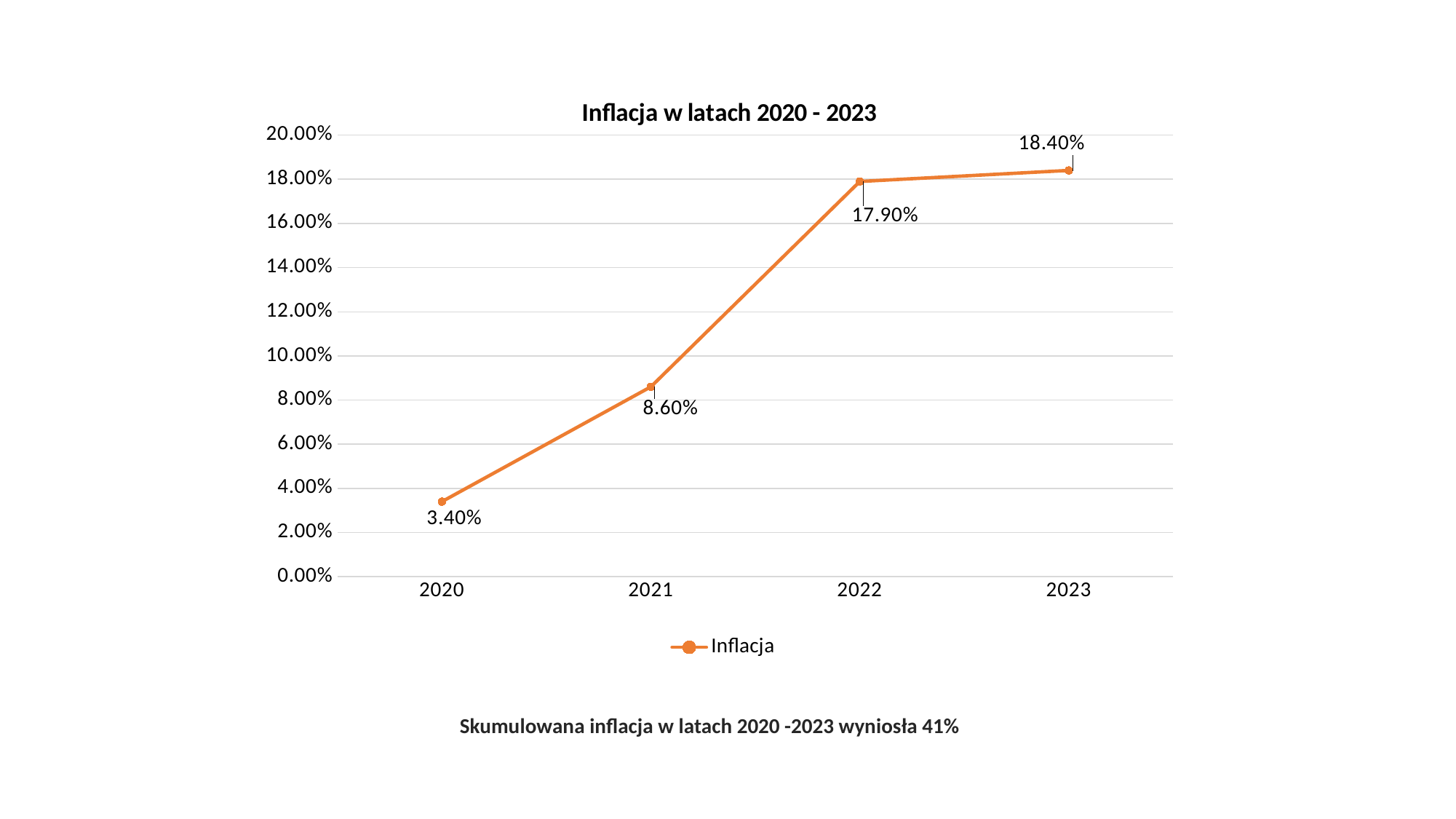
Do the inflation values rise or fall from 2020 to 2023? rise What is the difference between the inflation values for 2022 and 2021? 9.30% What is the inflation value for 2023? 18.40% What kind of chart is shown on the slide? line chart Which year has the lowest inflation value? 2020 How many series does the legend list? 1 How many years are plotted on the chart? 4 Which is larger, the inflation value for 2021 or for 2022? 2022 Is the inflation value for 2022 greater or less than 16.00%? greater What is the inflation value for 2021? 8.60% Which year has the highest inflation value? 2023 What is the inflation value for 2020? 3.40%